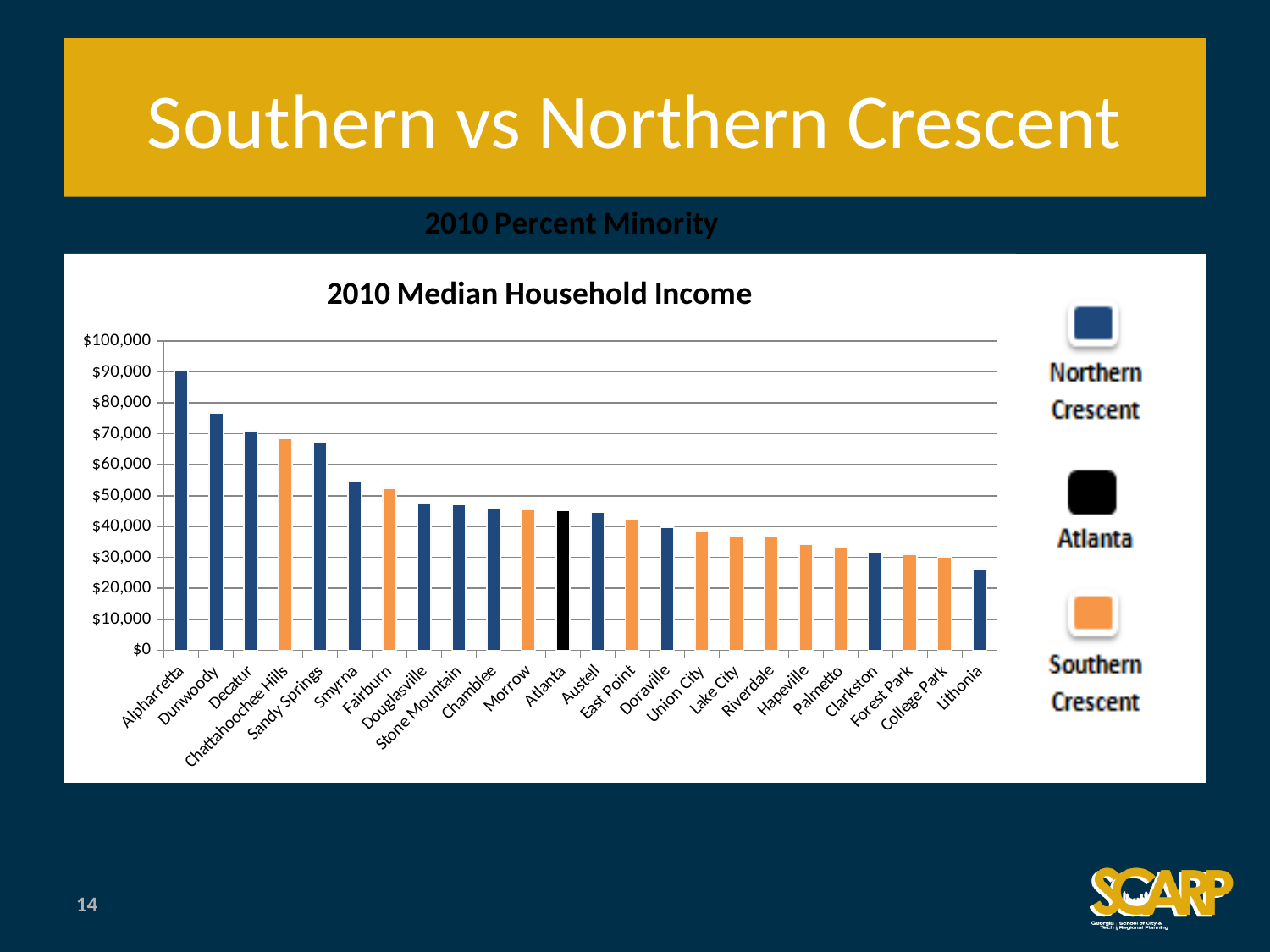
How many cities are plotted in the 2010 Median Household Income chart? 24 Which has a higher median household income, Dunwoody or Decatur? Dunwoody What colour is used for the Atlanta bar? black What kind of chart is shown on the slide? bar chart Which city has the lowest 2010 median household income? Lithonia Which city has the highest 2010 median household income? Alpharretta Which has a higher median household income, Sandy Springs or Smyrna? Sandy Springs Is the value for Chattahoochee Hills greater or less than $60,000? greater How many series does the legend list? 3 Do the values rise or fall moving from left to right along the x axis? fall Is the value for Alpharetta greater or less than $80,000? greater Is the value for Lithonia greater or less than $30,000? less